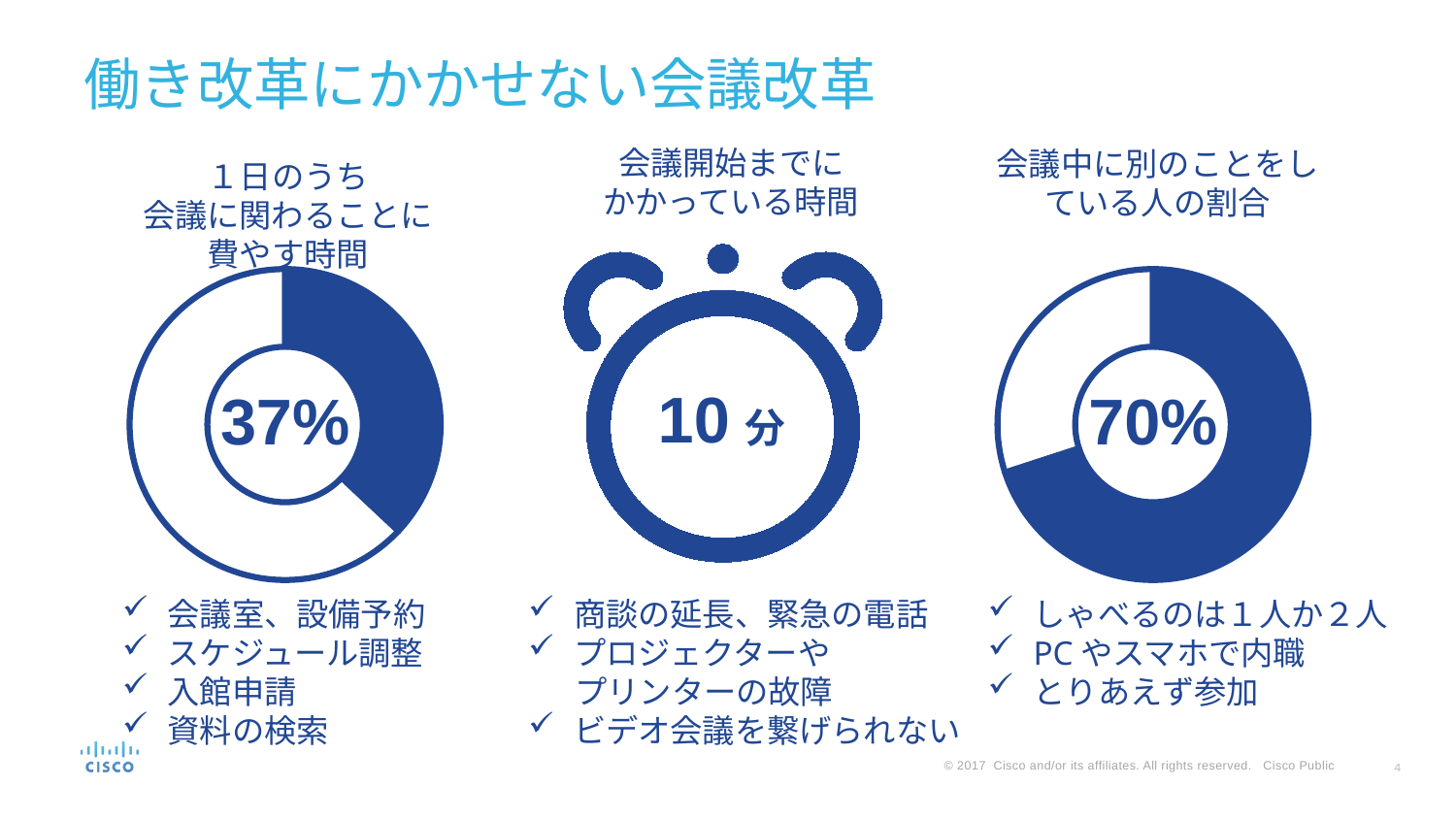
What kind of chart is used for the left figure showing 37%? Donut (pie) chart How many donut charts are on the slide? 2 What is the title above the left donut chart? １日のうち会議に関わることに費やす時間 Is the value in the left donut chart greater or less than 50%? less In the left donut chart, what share of the ring is not filled by the dark blue 37% segment? 63% In the left donut chart (１日のうち会議に関わることに費やす時間), what percentage is shown in the centre? 37% In the right donut chart (会議中に別のことをしている人の割合), what percentage is shown in the centre? 70% What is the difference between the percentage in the right donut chart and the percentage in the left donut chart? 33 percentage points What kind of chart is used for the right figure showing 70%? Donut (pie) chart Which chart shows the larger percentage, the left donut chart or the right donut chart? The right donut chart (70%) What is the title above the right donut chart? 会議中に別のことをしている人の割合 Is the value in the right donut chart greater or less than 50%? greater